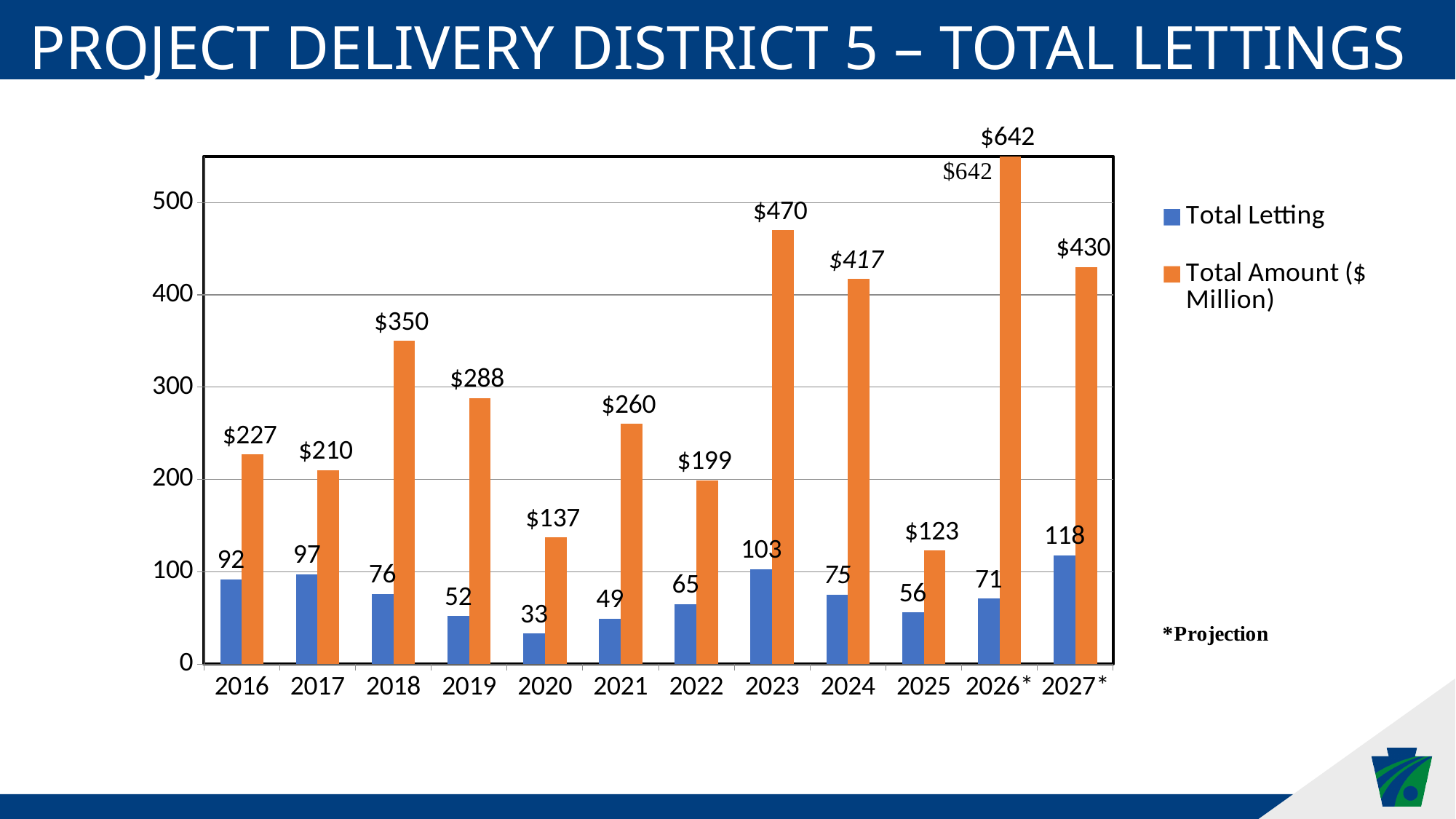
Is the Total Amount ($ Million) for 2021 greater or less than 300? less What is the Total Letting value for 2023? 103 Which year has the lowest Total Letting value? 2020 What is the difference between the Total Amount ($ Million) for 2023 and 2024? $53 How many series does the legend list? 2 Which is larger, the Total Letting value for 2017 or for 2018? 2017 What colour are the Total Amount ($ Million) bars? orange What is the Total Amount ($ Million) for 2019? $288 What kind of chart is shown on the slide? bar chart Does the Total Amount ($ Million) rise or fall from 2018 to 2020? fall How many years are shown on the x axis? 12 Which year has the highest Total Amount ($ Million)? 2026*